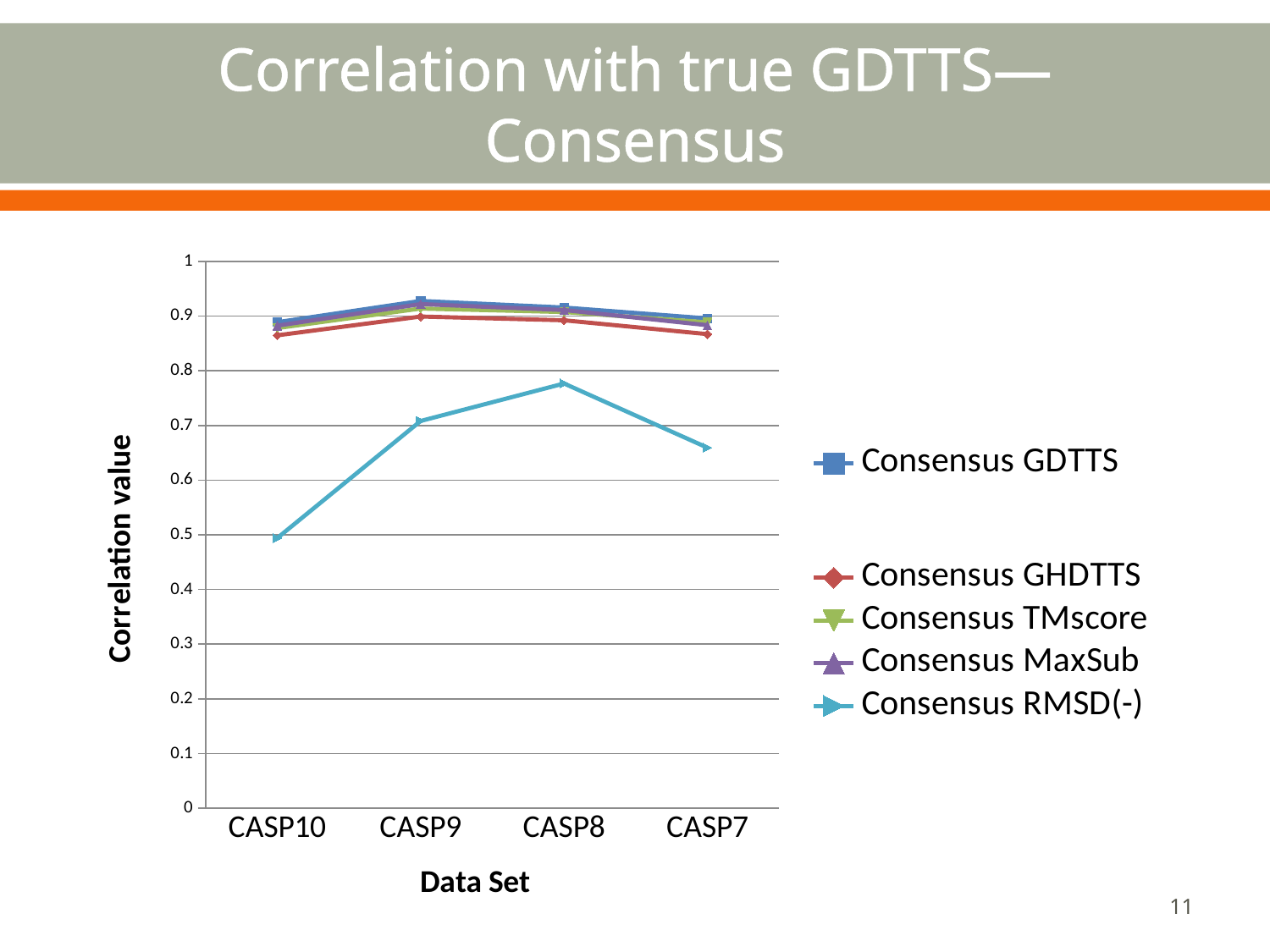
What kind of chart is shown on the slide? line chart Is the value for Consensus RMSD(-) at CASP10 greater or less than 0.6? less For Consensus RMSD(-), is the value at CASP9 or at CASP7 larger? CASP9 For the Consensus RMSD(-) series, which data set has the lowest value? CASP10 How many data sets are shown on the x axis? 4 For the Consensus RMSD(-) series, which data set has the highest value? CASP8 Is the value for Consensus GDTTS at CASP9 greater or less than 0.9? greater Does the Consensus RMSD(-) series rise or fall from CASP10 to CASP9? rise Is the value for Consensus RMSD(-) at CASP8 greater or less than 0.7? greater Which series has the lowest value at CASP10? Consensus RMSD(-) How many series does the legend list? 5